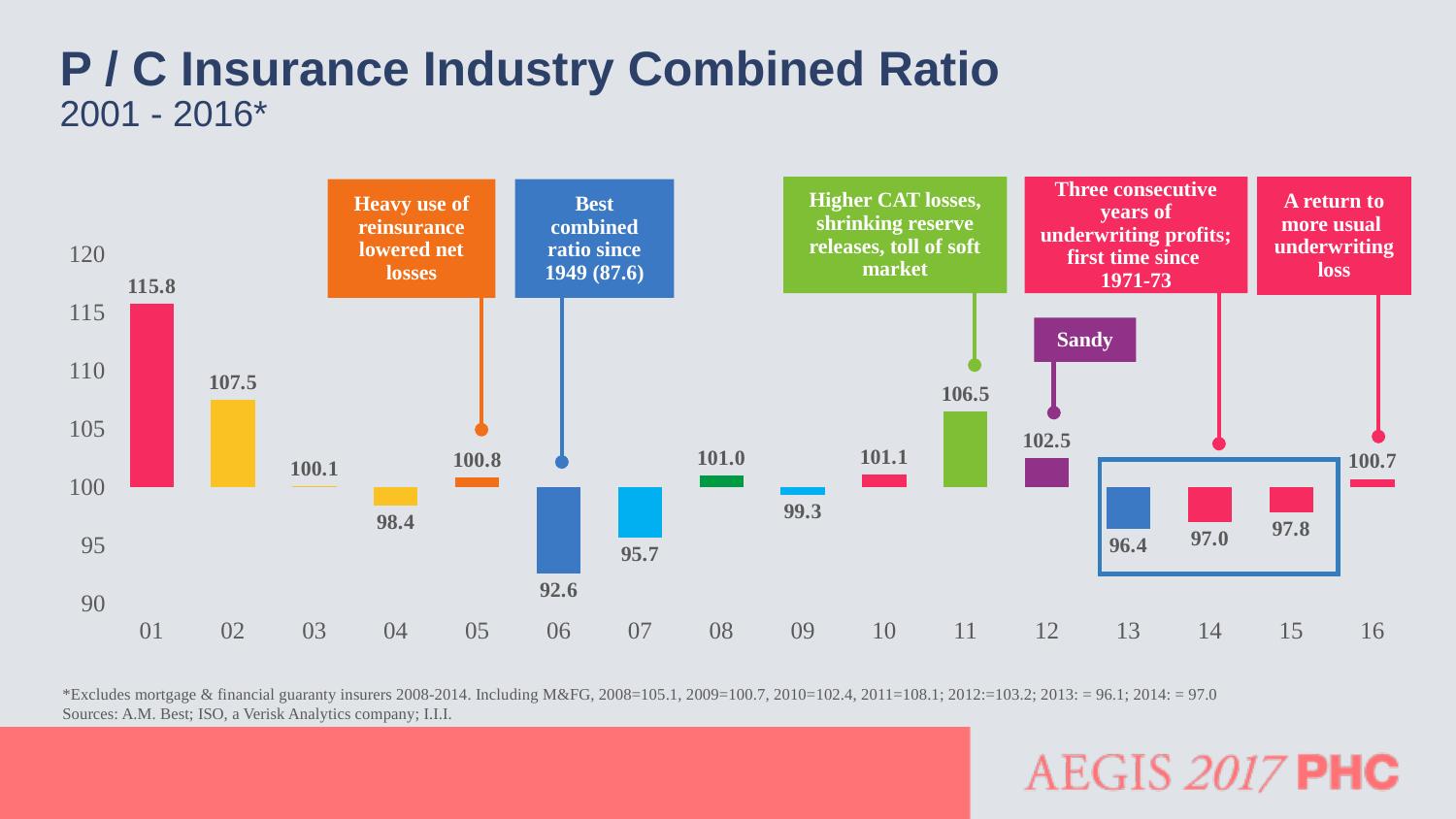
Which year has the highest combined ratio? 01 What is the combined ratio shown for 2012 (12)? 102.5 Is the combined ratio for 2011 (11) greater or less than 105? greater Which year has the lowest combined ratio? 06 What does the callout above the 2012 (12) bar say? Sandy How many years are plotted on the chart? 16 Which year has a higher combined ratio, 2013 (13) or 2015 (15)? 15 What type of chart is shown on the slide? Bar chart What is the combined ratio shown for 2006 (06)? 92.6 What is the combined ratio for 2001 (01)? 115.8 What is the difference between the combined ratio in 2011 (11) and 2012 (12)? 4.0 What is the difference between the combined ratio in 2001 (01) and 2002 (02)? 8.3